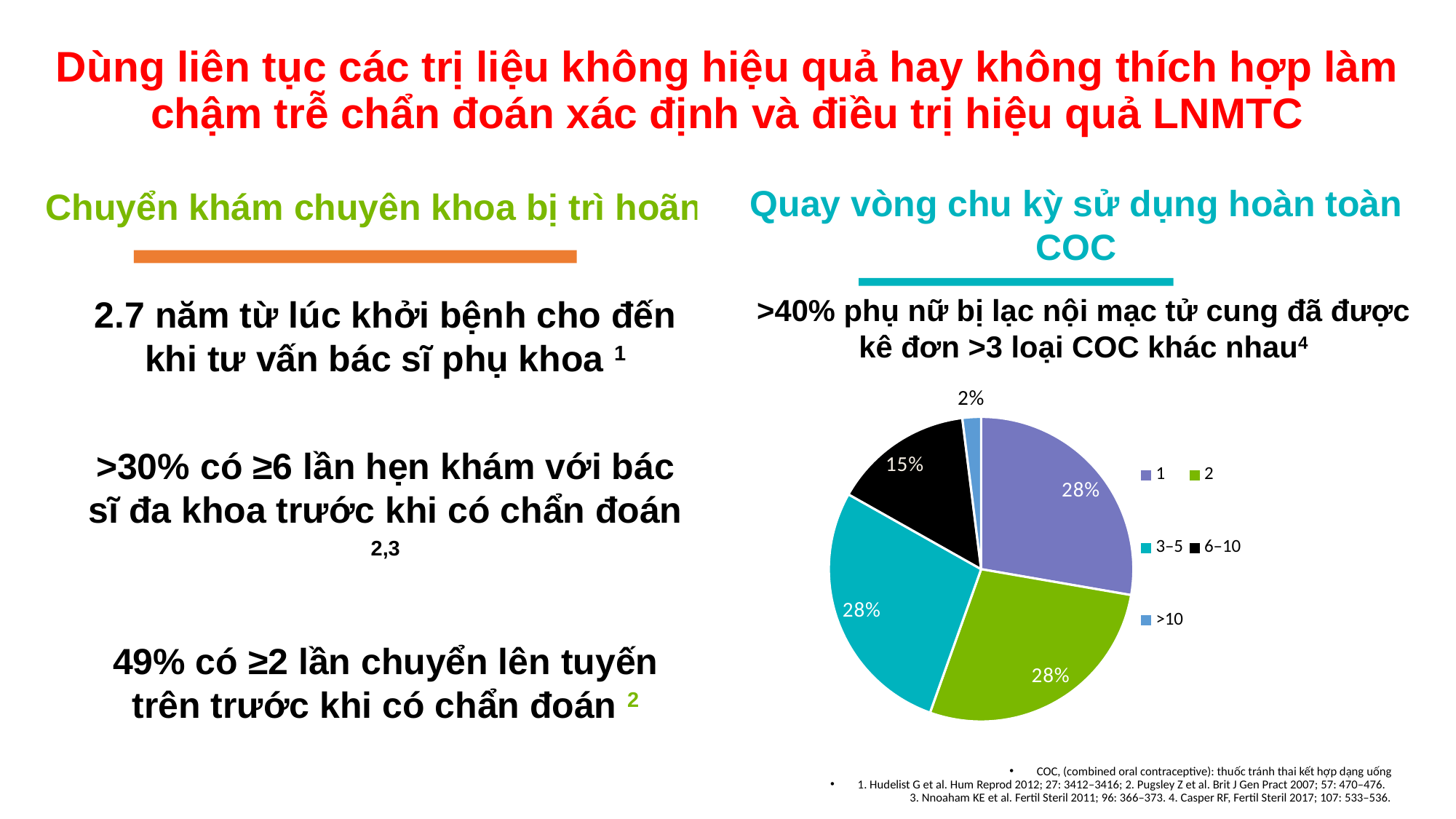
How many entries does the legend of the pie chart list? 5 In the pie chart, what share is shown for the category "6–10"? 15% In the pie chart, what share is shown for the category "3–5"? 28% What is the difference in percentage points between the "1" slice and the "6–10" slice? 13 How many categories does the pie chart show? 5 Which slice is larger, "6–10" or ">10"? 6–10 What colour is the slice for the category "6–10" in the pie chart? black What kind of chart is shown on the slide? pie chart Which category has the smallest slice in the pie chart? >10 In the pie chart, what share is shown for the category ">10"? 2% In the pie chart, what share is shown for the category "1"? 28% In the pie chart, what share is shown for the category "2"? 28%